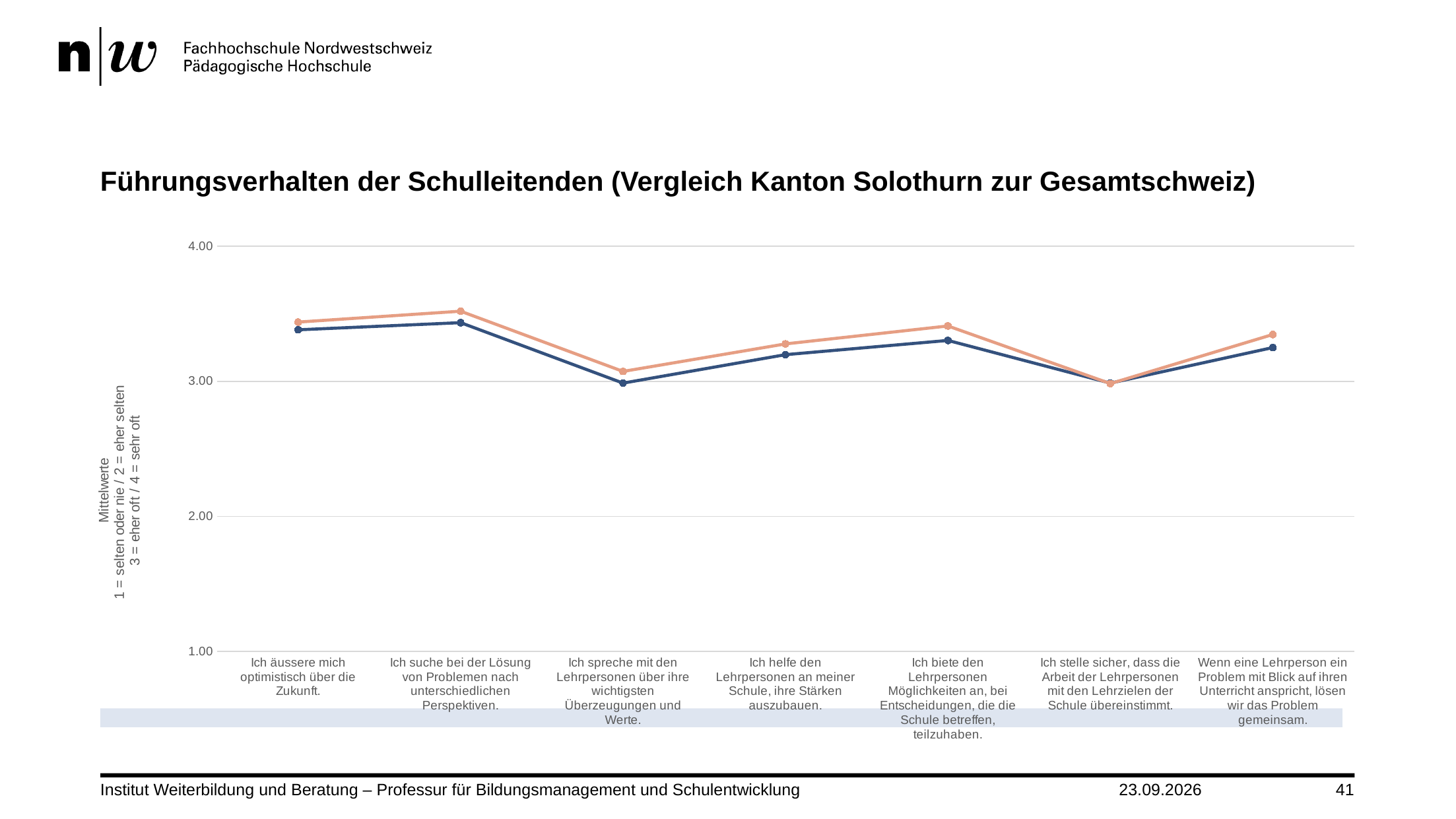
Do the lines rise or fall from "Ich suche bei der Lösung von Problemen nach unterschiedlichen Perspektiven." to "Ich spreche mit den Lehrpersonen über ihre wichtigsten Überzeugungen und Werte."? fall For which category does the orange line reach its lowest value? Ich stelle sicher, dass die Arbeit der Lehrpersonen mit den Lehrzielen der Schule übereinstimmt. How many lines are plotted in the chart? 2 How many categories are shown on the x axis of the chart? 7 What is the title of the chart on the slide? Führungsverhalten der Schulleitenden (Vergleich Kanton Solothurn zur Gesamtschweiz) Is the value of the dark blue line for "Ich äussere mich optimistisch über die Zukunft." greater or less than 4.00? less Is the value of the orange line for "Ich suche bei der Lösung von Problemen nach unterschiedlichen Perspektiven." greater or less than 3.00? greater For "Ich biete den Lehrpersonen Möglichkeiten an, bei Entscheidungen, die die Schule betreffen, teilzuhaben.", which line has the higher value, the orange line or the dark blue line? the orange line What kind of chart is shown on the slide? line chart What is the label of the y axis? Mittelwerte 1 = selten oder nie / 2 = eher selten 3 = eher oft / 4 = sehr oft Do the lines rise or fall from "Ich stelle sicher, dass die Arbeit der Lehrpersonen mit den Lehrzielen der Schule übereinstimmt." to "Wenn eine Lehrperson ein Problem mit Blick auf ihren Unterricht anspricht, lösen wir das Problem gemeinsam."? rise For which category does the orange line reach its highest value? Ich suche bei der Lösung von Problemen nach unterschiedlichen Perspektiven.